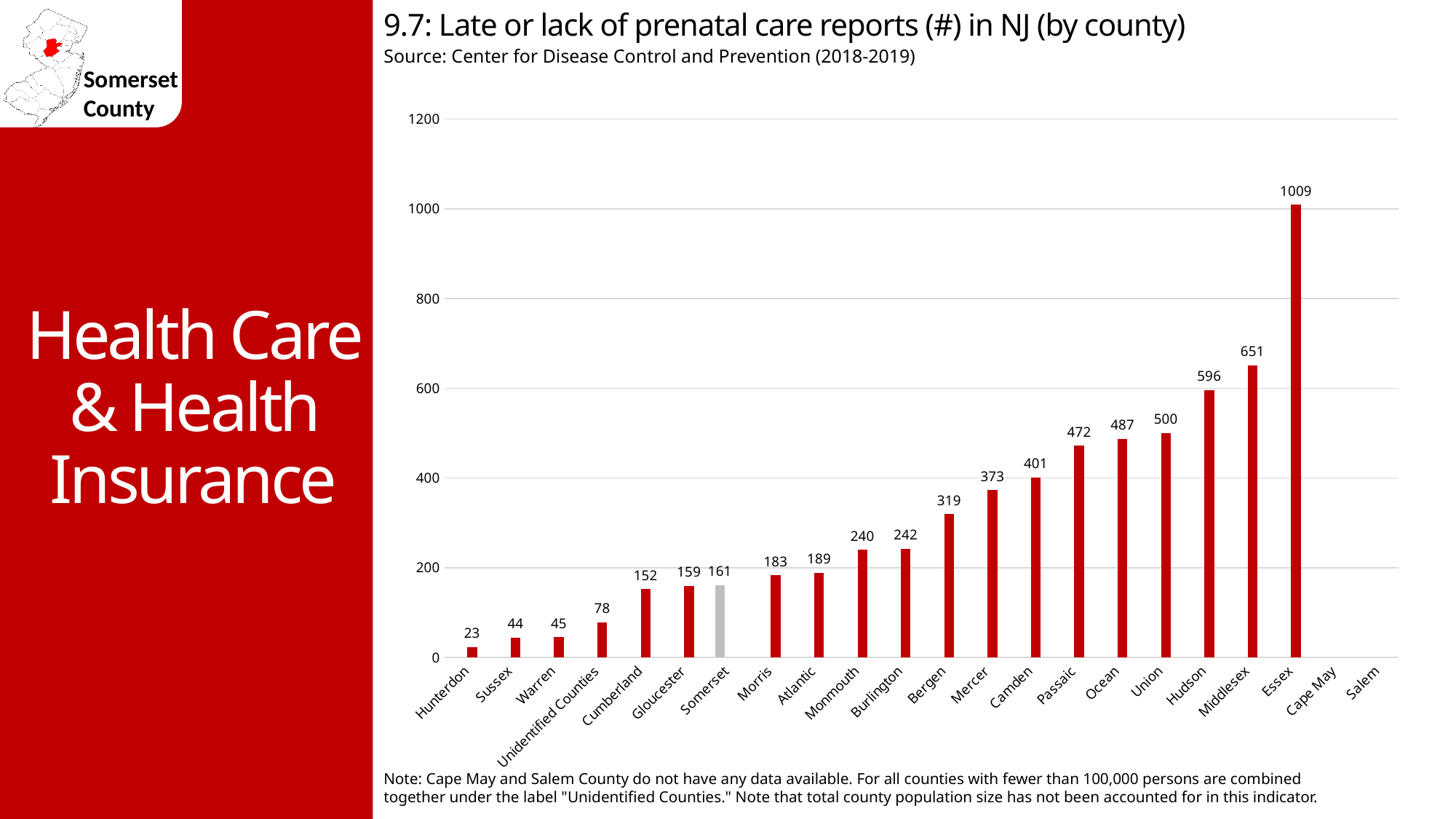
Which has a larger value, Bergen or Mercer? Mercer What is the value shown for Hunterdon? 23 Do the values generally rise or fall from left to right across the counties with bars? Rise What is the difference between the values for Middlesex and Hudson? 55 Is the value for Passaic greater or less than 400? greater Which bar is coloured grey instead of red? Somerset What kind of chart is shown on the slide? Bar chart How many categories are listed along the x axis? 22 What is the value shown for Essex? 1009 What is the number of late or lack of prenatal care reports for Somerset? 161 Which county has the highest number of late or lack of prenatal care reports? Essex Which county with a plotted bar has the lowest number of reports? Hunterdon